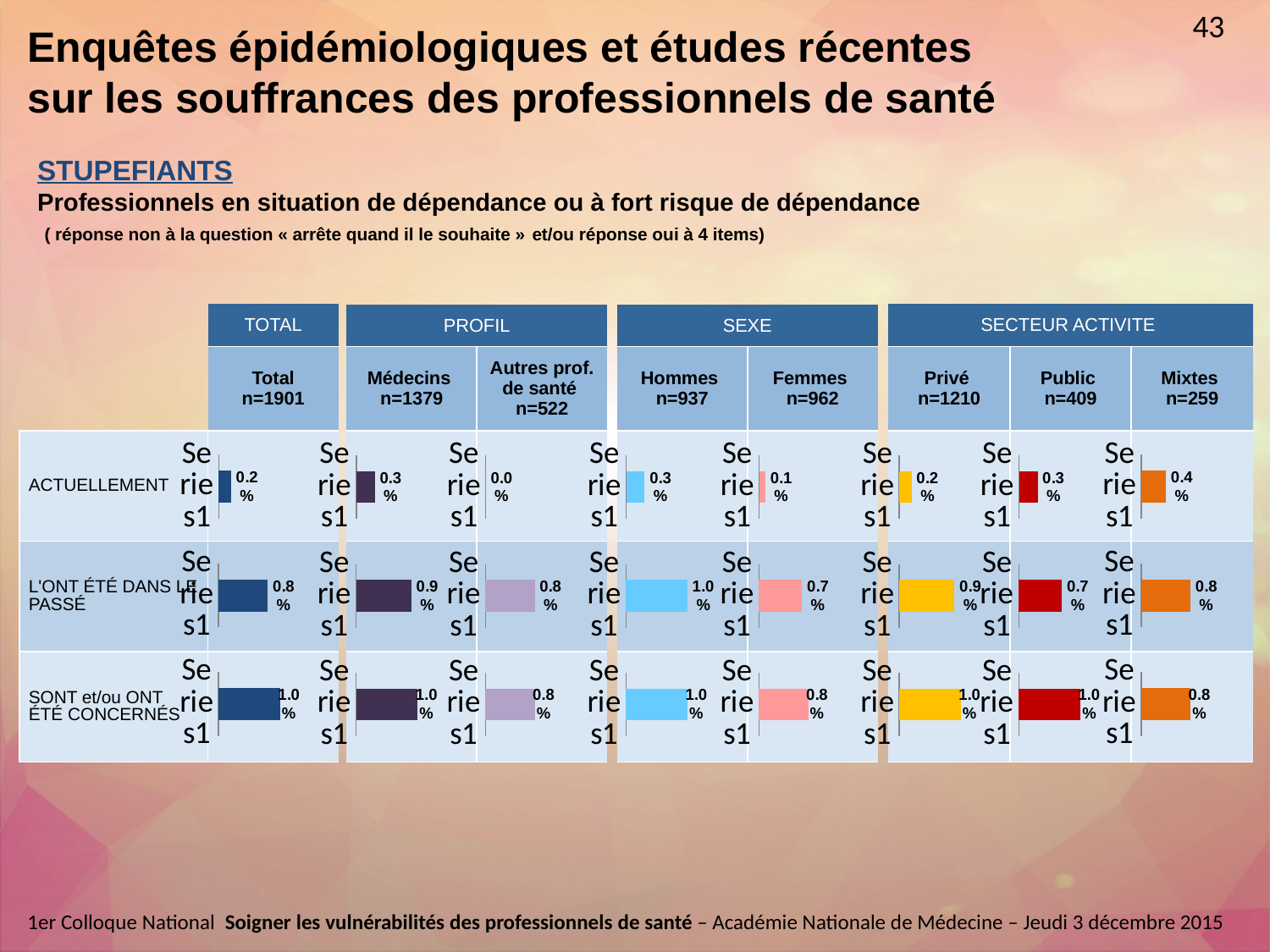
In the ACTUELLEMENT row, which column has the lowest value? Autres prof. de santé n=522 In the L'ONT ÉTÉ DANS LE PASSÉ row, what value is shown for Hommes n=937? 1.0 % How many columns of charts (Total, Médecins, Autres prof. de santé, Hommes, Femmes, Privé, Public, Mixtes) are shown? 8 In the ACTUELLEMENT row, which column has the highest value? Mixtes n=259 In the SONT et/ou ONT ÉTÉ CONCERNÉS row, what value is shown for Total n=1901? 1.0 % What kind of chart is used in each cell of the grid? Bar chart In the ACTUELLEMENT row, which is larger: the value for Médecins or for Autres prof. de santé? Médecins In the L'ONT ÉTÉ DANS LE PASSÉ row, what is the difference between the Hommes and Femmes values? 0.3 % In the ACTUELLEMENT row, what value is shown for Mixtes n=259? 0.4 % In the SONT et/ou ONT ÉTÉ CONCERNÉS row, what is the difference between the Privé and Mixtes values? 0.2 % In the L'ONT ÉTÉ DANS LE PASSÉ row, what value is shown for Public n=409? 0.7 % In the ACTUELLEMENT row, what value is shown for Femmes n=962? 0.1 %